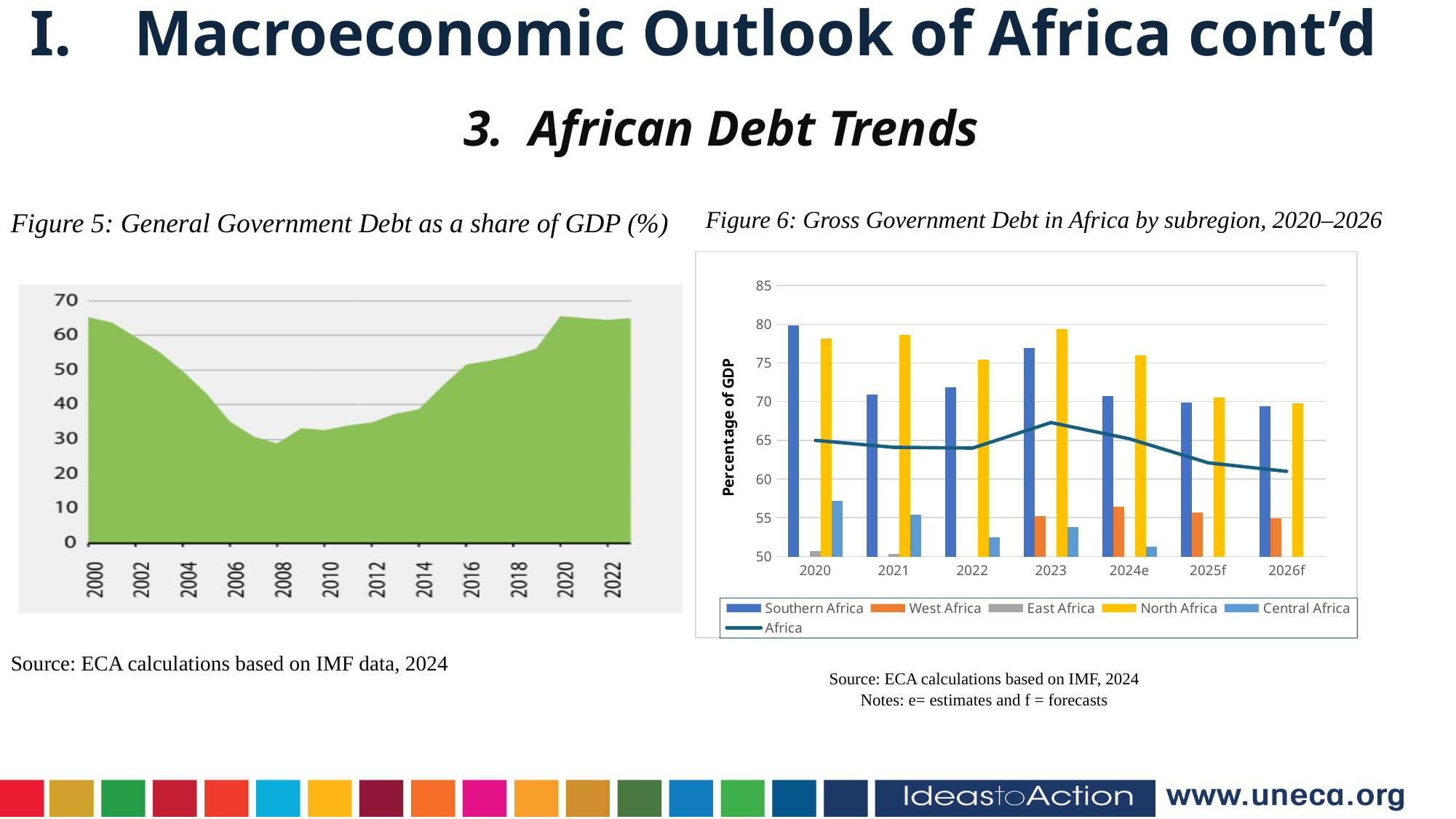
In Figure 6, how many years are shown on the x axis? 7 In Figure 6, which is larger: North Africa in 2021 or North Africa in 2022? North Africa in 2021 In Figure 5, is the value for 2000 greater or less than 60? greater In Figure 5, do the values rise or fall from 2000 to 2008? fall In Figure 5, do the values rise or fall from 2008 to 2020? rise In Figure 6, how many series does the legend list? 6 What kind of chart is Figure 5: General Government Debt as a share of GDP (%)? area chart In Figure 6, is the value for Southern Africa in 2020 greater or less than 75? greater What kind of chart is Figure 6: Gross Government Debt in Africa by subregion, 2020–2026? bar chart with a line In Figure 6, what is the label on the y axis? Percentage of GDP In Figure 5, is the value for 2012 greater or less than 40? less